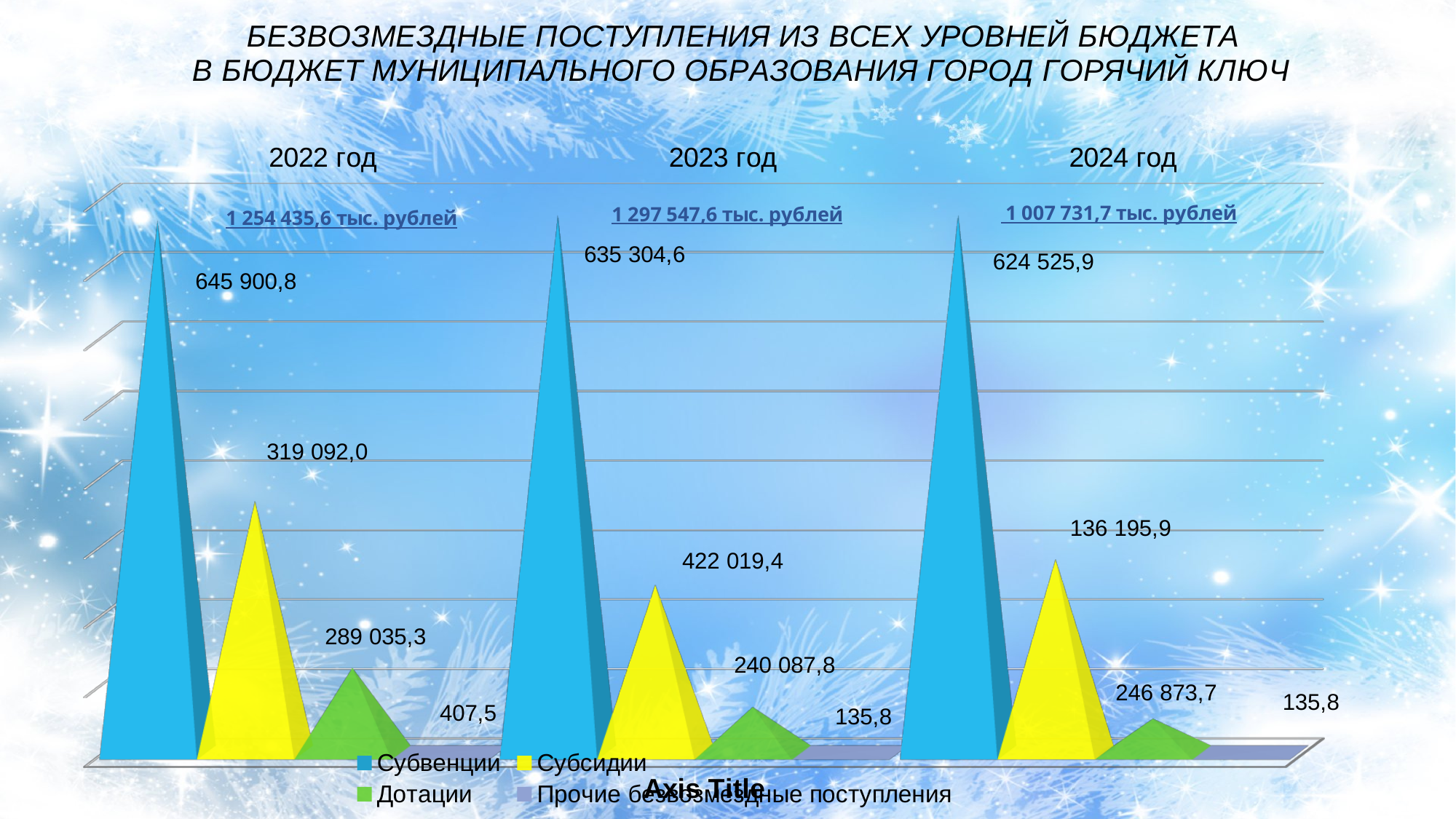
Do the values of Субвенции rise or fall from 2022 год to 2024 год? fall What is the value of Субвенции for 2022 год? 645 900,8 What is the value of Прочие безвозмездные поступления for 2022 год? 407,5 How many years are shown on the x axis? 3 What is the value of Субсидии for 2023 год? 422 019,4 How many series does the legend list? 4 What is the value of Дотации for 2024 год? 246 873,7 Which year has the highest total of безвозмездные поступления? 2023 год Which is larger in 2023 год: Субсидии or Дотации? Субсидии What total is shown for 2023 год? 1 297 547,6 тыс. рублей What is the difference between Субвенции and Субсидии in 2022 год? 326 808,8 Which year has the lowest total of безвозмездные поступления? 2024 год